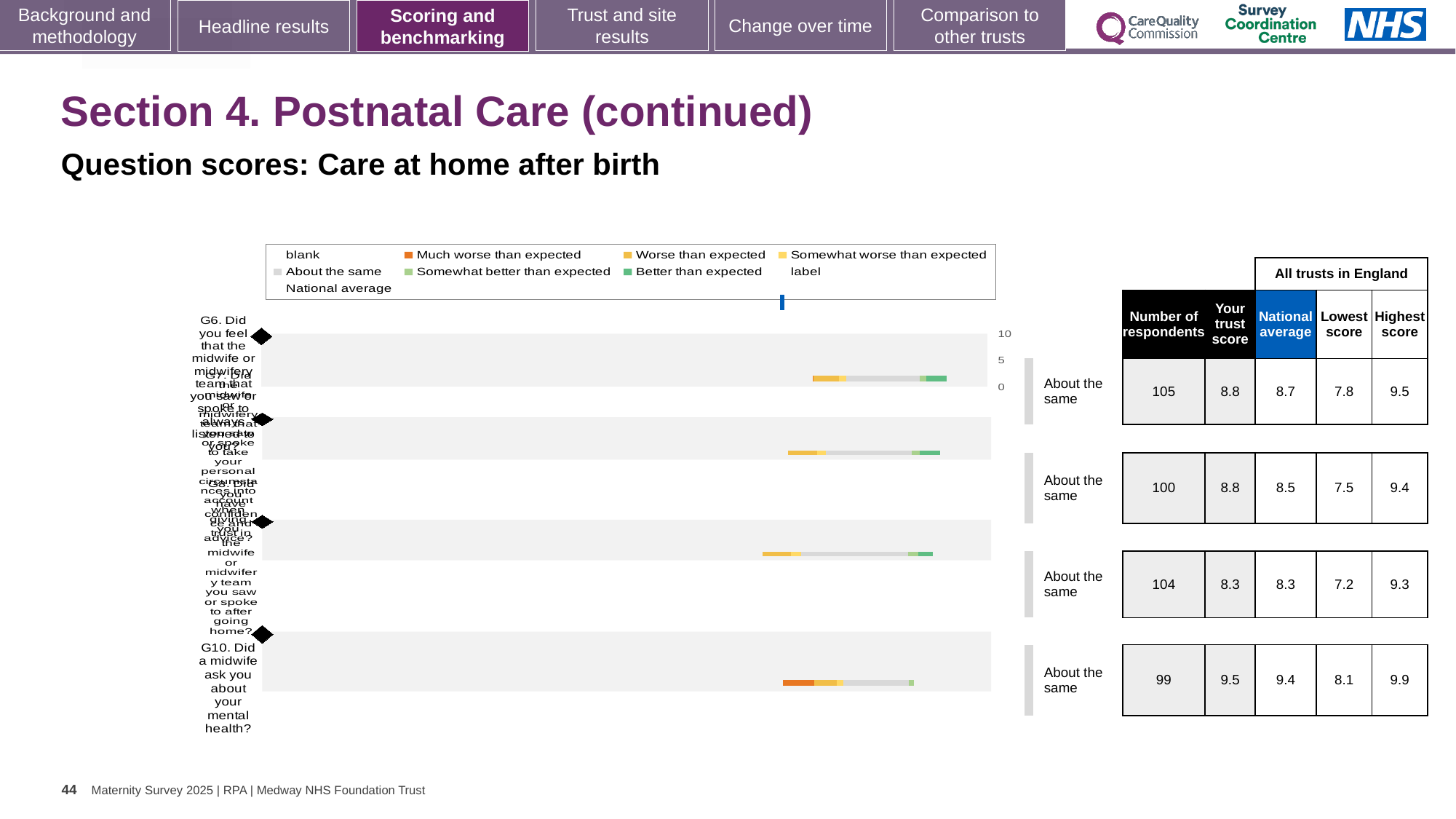
How many question rows (bars) are plotted in the chart? 4 What kind of chart is shown on the slide? Bar chart Which question row has the highest trust score? G10 (bottom row) Which row has the lowest trust score? The third row from the top (8.3) For question G10, what is the difference between the highest score and the lowest score across all trusts? 1.8 For the top row (G6), which is larger: the trust score or the national average? The trust score (8.8) What benchmark category is shown for every question row in the chart? About the same What is the highest score across all trusts in England for the second row from the top? 9.4 What is the trust score for question G10 (the bottom row of the chart)? 9.5 What is the national average for the top row (G6) of the chart? 8.7 How many respondents are shown for question G6 (the top row of the chart)? 105 How many more respondents answered the top row (G6) than the bottom row (G10)? 6